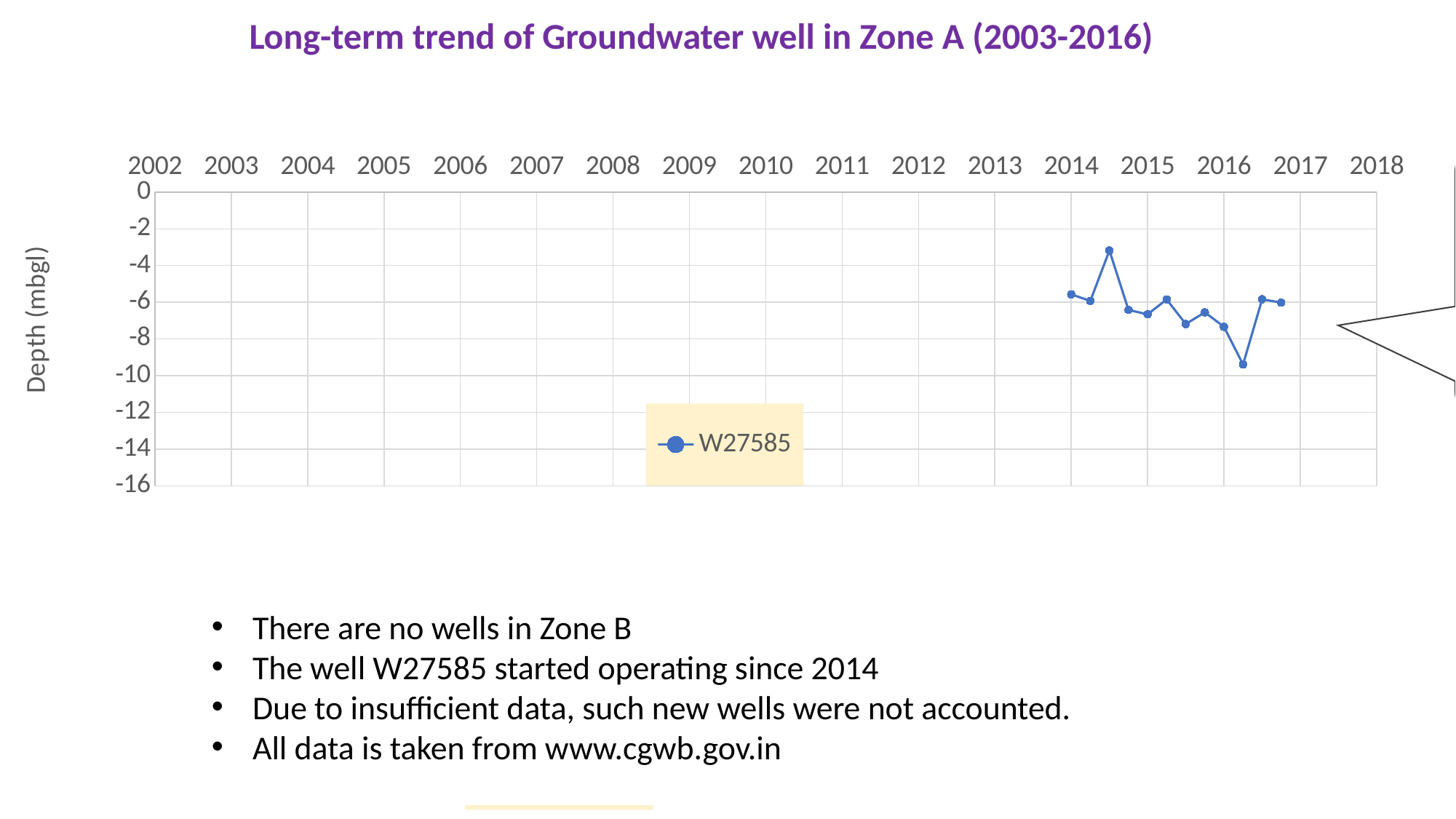
What is the name of the series shown in the legend? W27585 What kind of chart is shown on the slide? Line chart Is the first plotted point of W27585 in 2014 greater or less than -6? greater Is the lowest point of the W27585 line greater or less than -8? less In which year does the W27585 line reach its lowest depth value? 2016 Is the W27585 line's sharp dip in 2016 greater or less than -10? greater How many series does the legend list? 1 How many data points are plotted for W27585? 12 In which year does the W27585 line reach its highest depth value? 2014 What is the label on the vertical axis? Depth (mbgl)